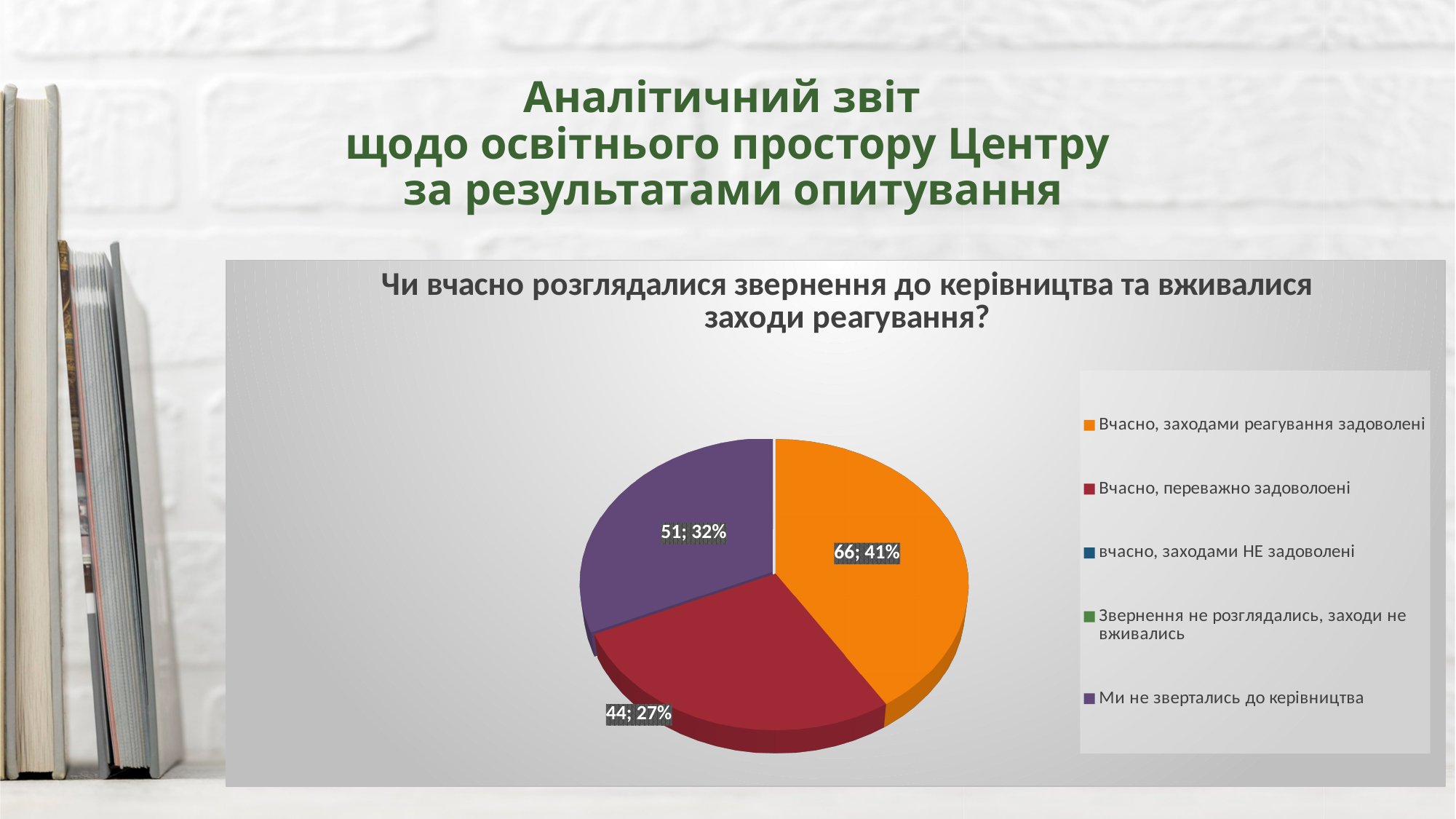
What kind of chart is shown on the slide? pie chart What share of the pie does "Вчасно, переважно задоволоені" take? 27% What is the value for "Ми не звертались до керівництва"? 51 What is the value for "Вчасно, заходами реагування задоволені"? 66 Which is larger: the value for "Ми не звертались до керівництва" or for "Вчасно, переважно задоволоені"? Ми не звертались до керівництва How many entries does the chart legend list? 5 What share of the pie does "Ми не звертались до керівництва" take? 32% Which category has the largest slice? Вчасно, заходами реагування задоволені How many slices are visible in the pie chart? 3 What is the difference between the values for "Вчасно, заходами реагування задоволені" and "Вчасно, переважно задоволоені"? 22 Which of the visible slices is the smallest? Вчасно, переважно задоволоені What is the title of the chart? Чи вчасно розглядалися звернення до керівництва та вживалися заходи реагування?